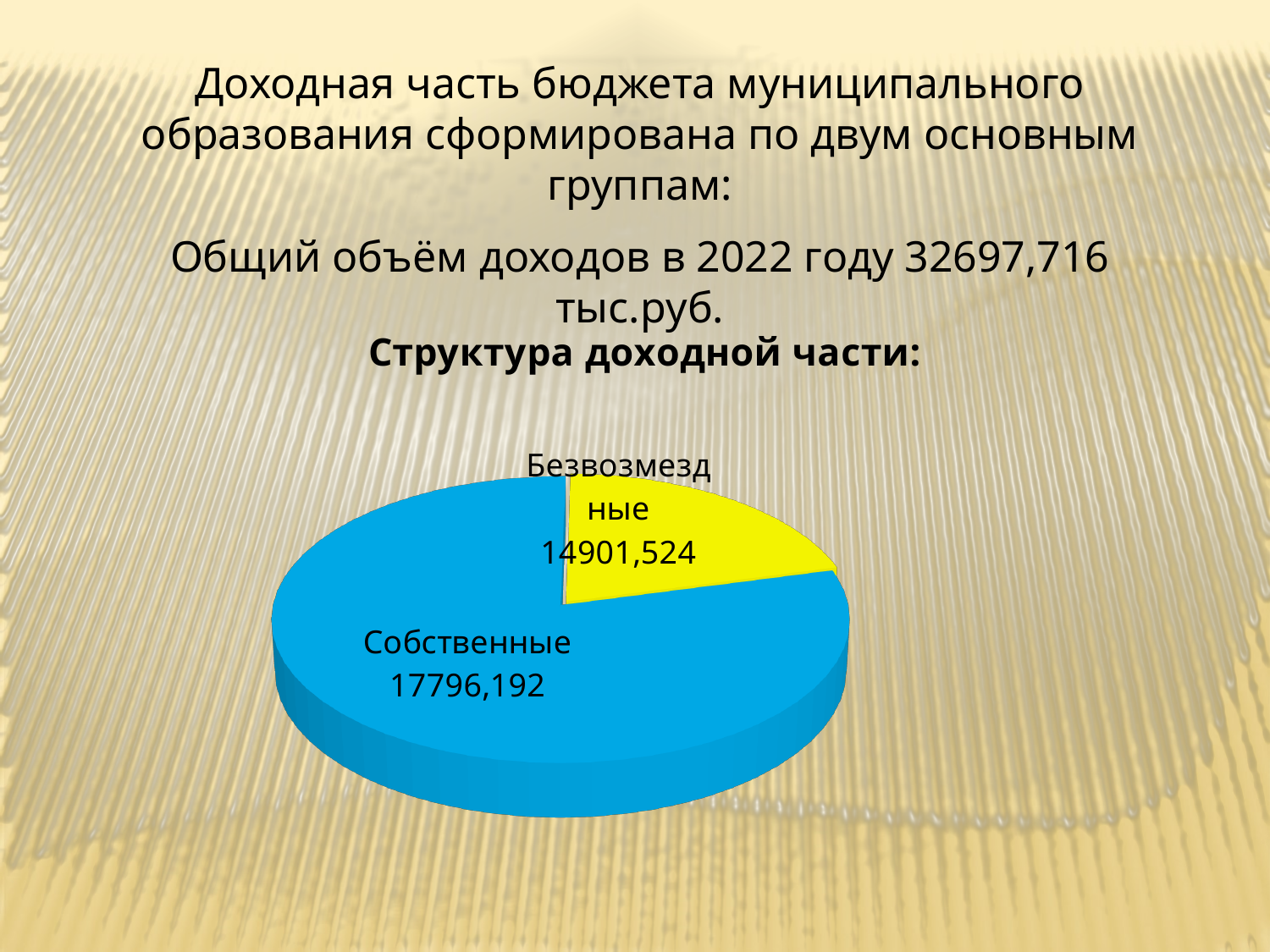
How many slices does the pie chart have? 2 What colour is the Безвозмездные slice? Yellow Which is larger, Собственные or Безвозмездные? Собственные What is the total of the two values shown in the pie chart? 32697,716 What is the value shown for Собственные? 17796,192 What is the difference between the values for Собственные and Безвозмездные? 2894,668 What is the value shown for Безвозмездные? 14901,524 Which category has the smallest value in the pie chart? Безвозмездные What kind of chart is shown on the slide? Pie chart Which category has the largest value in the pie chart? Собственные What colour is the Собственные slice? Blue